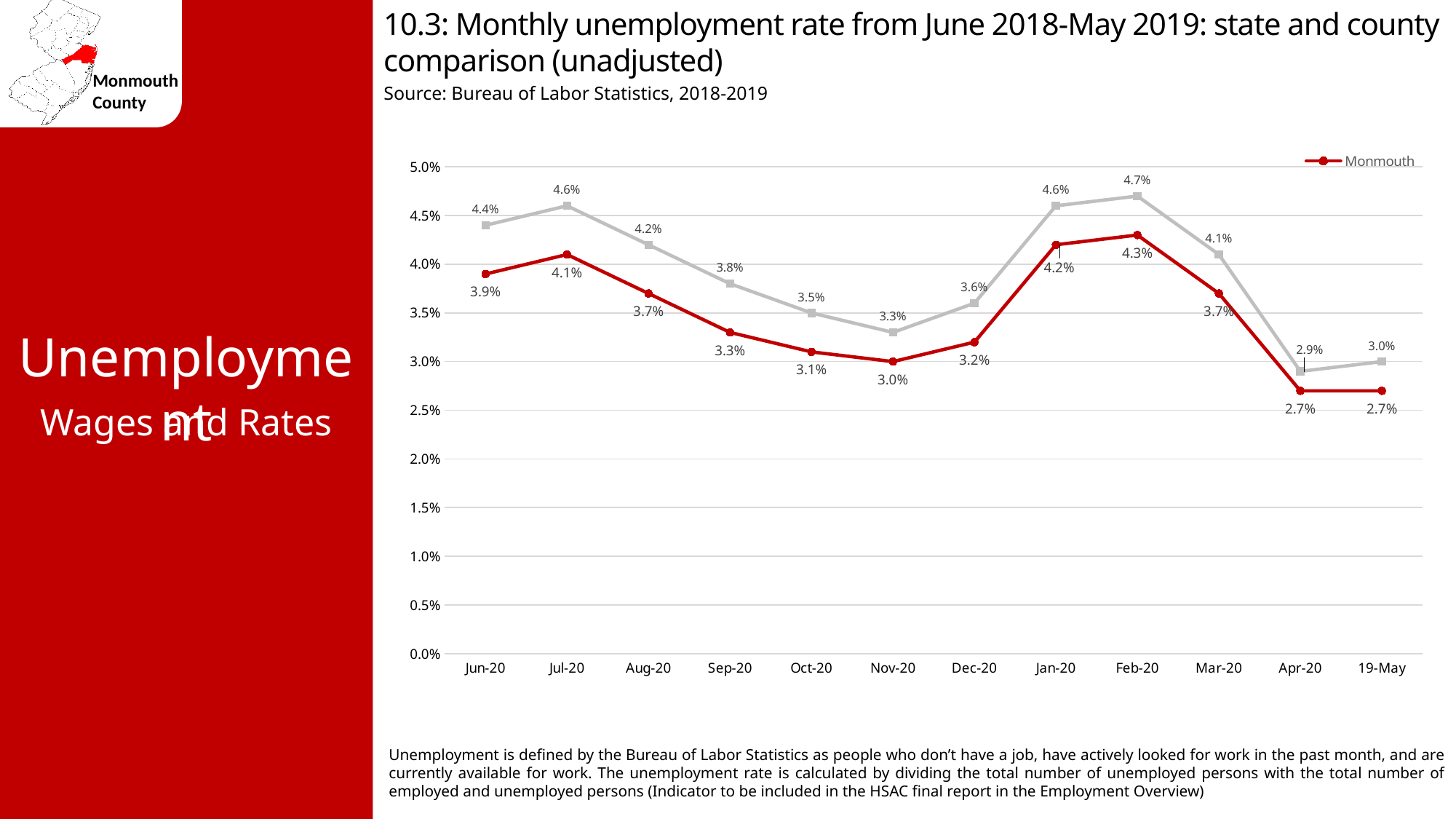
What is the Monmouth unemployment rate for Nov-20? 3.0% What is the Monmouth unemployment rate for Feb-20? 4.3% What is the Monmouth unemployment rate for Apr-20? 2.7% Does the Monmouth line rise or fall from Jul-20 to Nov-20? Fall What series name does the legend list? Monmouth In which month is the Monmouth unemployment rate highest? Feb-20 How many months are plotted on the x axis? 12 What type of chart is shown on the slide? Line chart Is the Monmouth rate for Sep-20 greater or less than 3.5%? less What is the Monmouth unemployment rate for Jul-20? 4.1% What is the difference between the Monmouth rate in Feb-20 and in Nov-20? 1.3 percentage points Which is larger for Monmouth: the rate in Jan-20 or the rate in Dec-20? Jan-20